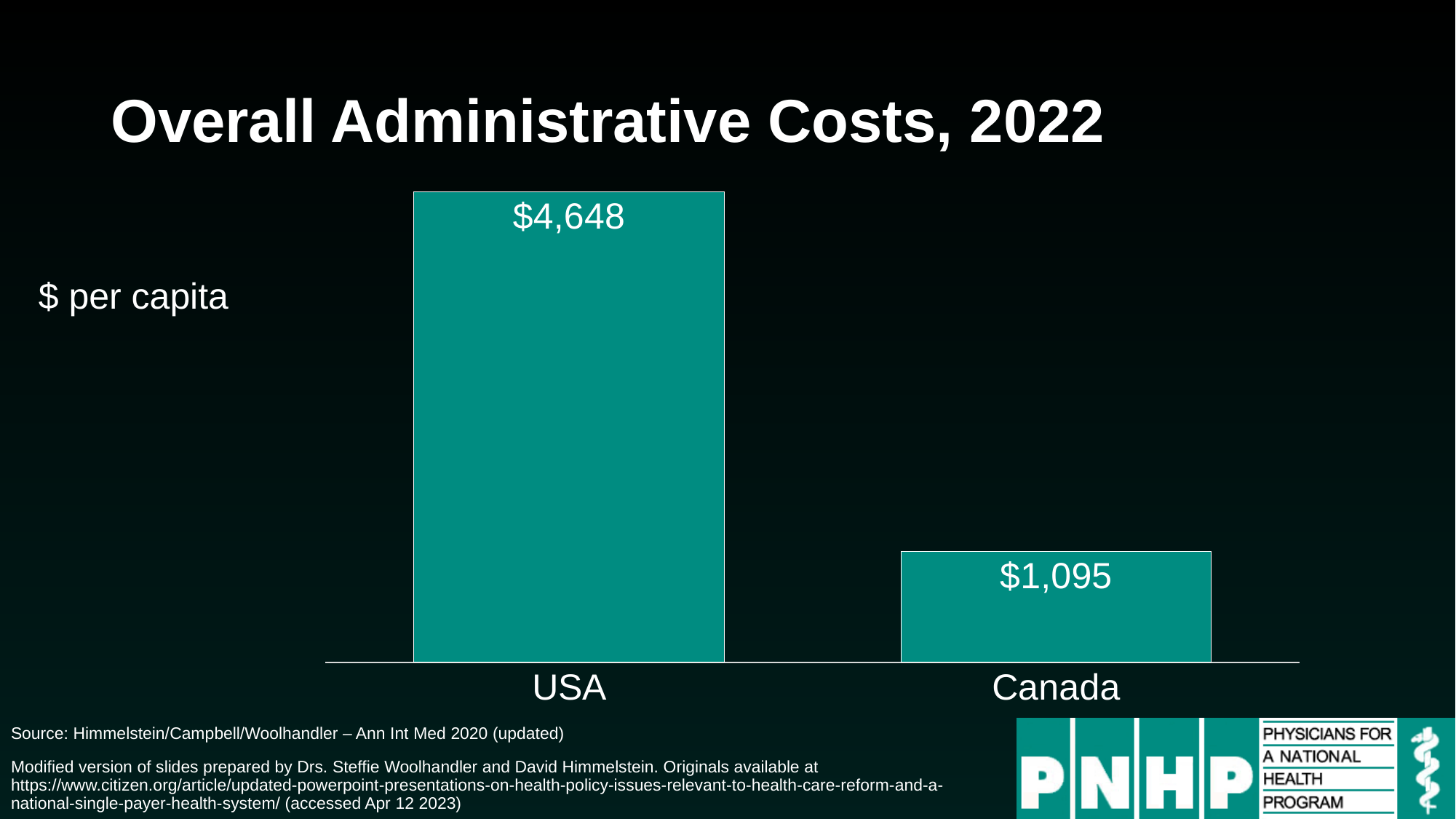
What kind of chart is shown on the slide? Bar chart What is the overall administrative cost per capita for Canada? $1,095 How many countries are shown in the chart? 2 What is the difference between the USA and Canada administrative costs per capita? $3,553 Is the administrative cost per capita larger for the USA or for Canada? USA What is the title of the chart? Overall Administrative Costs, 2022 In what unit are the values on the chart expressed? $ per capita Which country has the higher overall administrative cost per capita? USA Which country has the lower overall administrative cost per capita? Canada What is the overall administrative cost per capita for the USA? $4,648